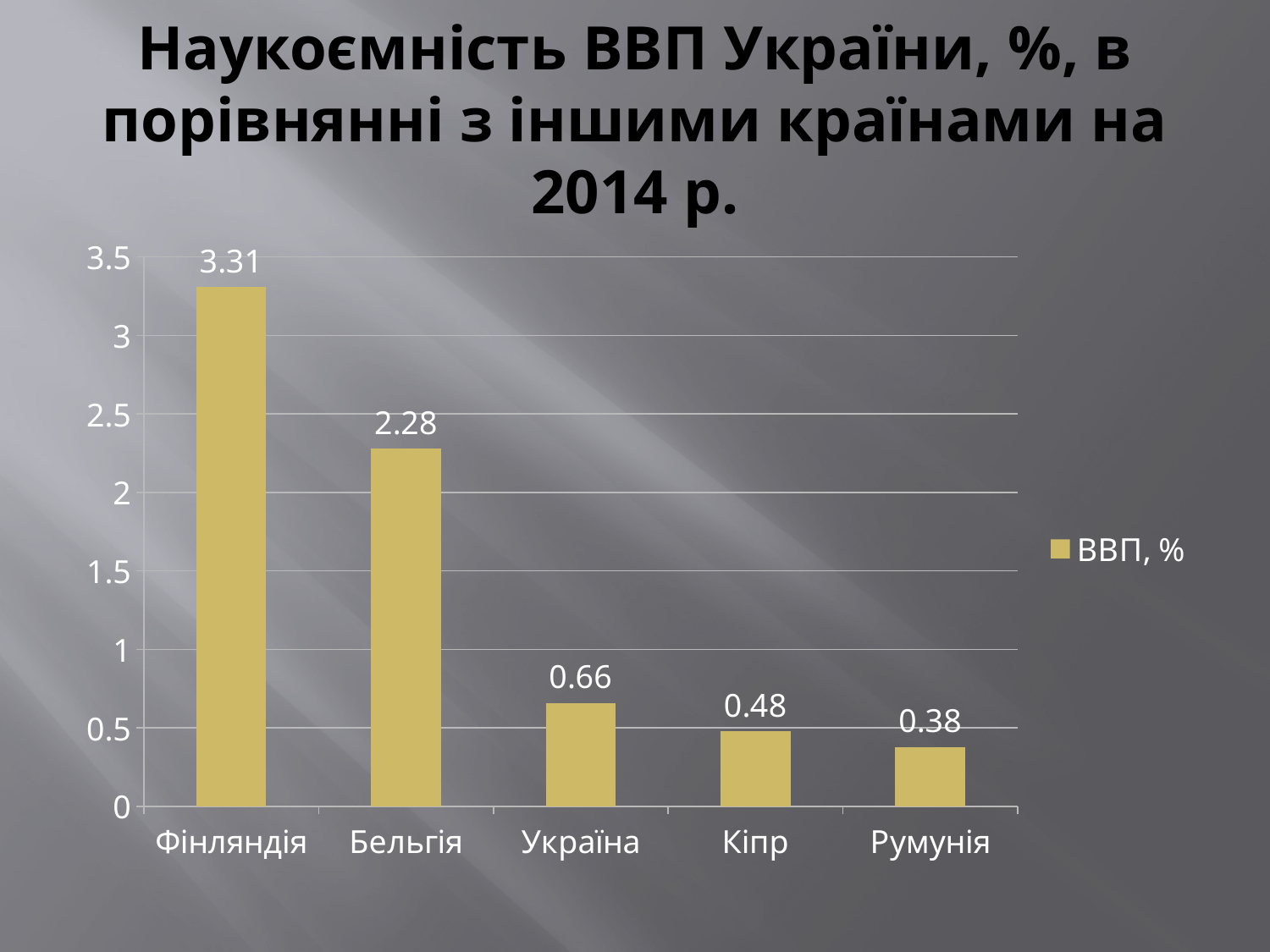
Which is larger, the value for Бельгія or the value for Україна? Бельгія Is the value for Кіпр greater or less than 0.5? less What series name does the legend show? ВВП, % What kind of chart is shown on the slide? bar chart Which country has the lowest value? Румунія What is the difference between the values for Україна and Кіпр? 0.18 What is the value for Румунія? 0.38 What is the difference between the values for Фінляндія and Бельгія? 1.03 What is the value for Фінляндія? 3.31 How many countries are shown on the chart? 5 Which country has the highest value? Фінляндія What is the value for Україна? 0.66